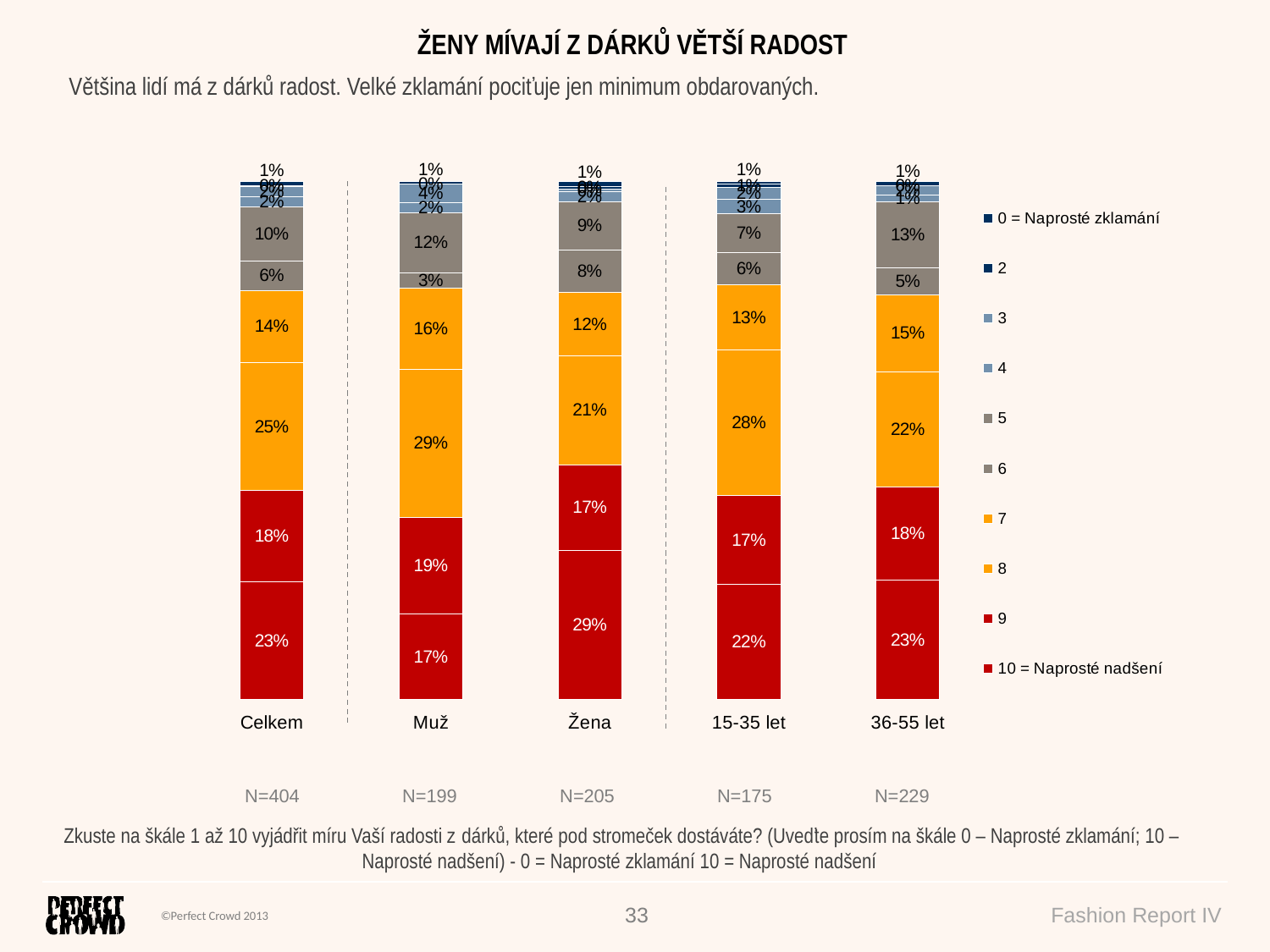
What kind of chart is shown on the slide? Stacked bar chart What is the value of the '6' segment for Muž? 3% What is the difference between the '10 = Naprosté nadšení' values for Žena and Muž? 12 percentage points What is the value of the '8' segment for Muž? 29% What sample size (N) is shown under the Celkem bar? N=404 Which category has the lowest value for '10 = Naprosté nadšení'? Muž How many series does the chart's legend list? 10 What is the value of the '5' segment for 36-55 let? 13% Which has the larger value for the '8' segment: 15-35 let or 36-55 let? 15-35 let What is the value of the '10 = Naprosté nadšení' segment for Žena? 29% How many categories (bars) are shown on the x axis of the chart? 5 Which category has the highest value for '10 = Naprosté nadšení'? Žena